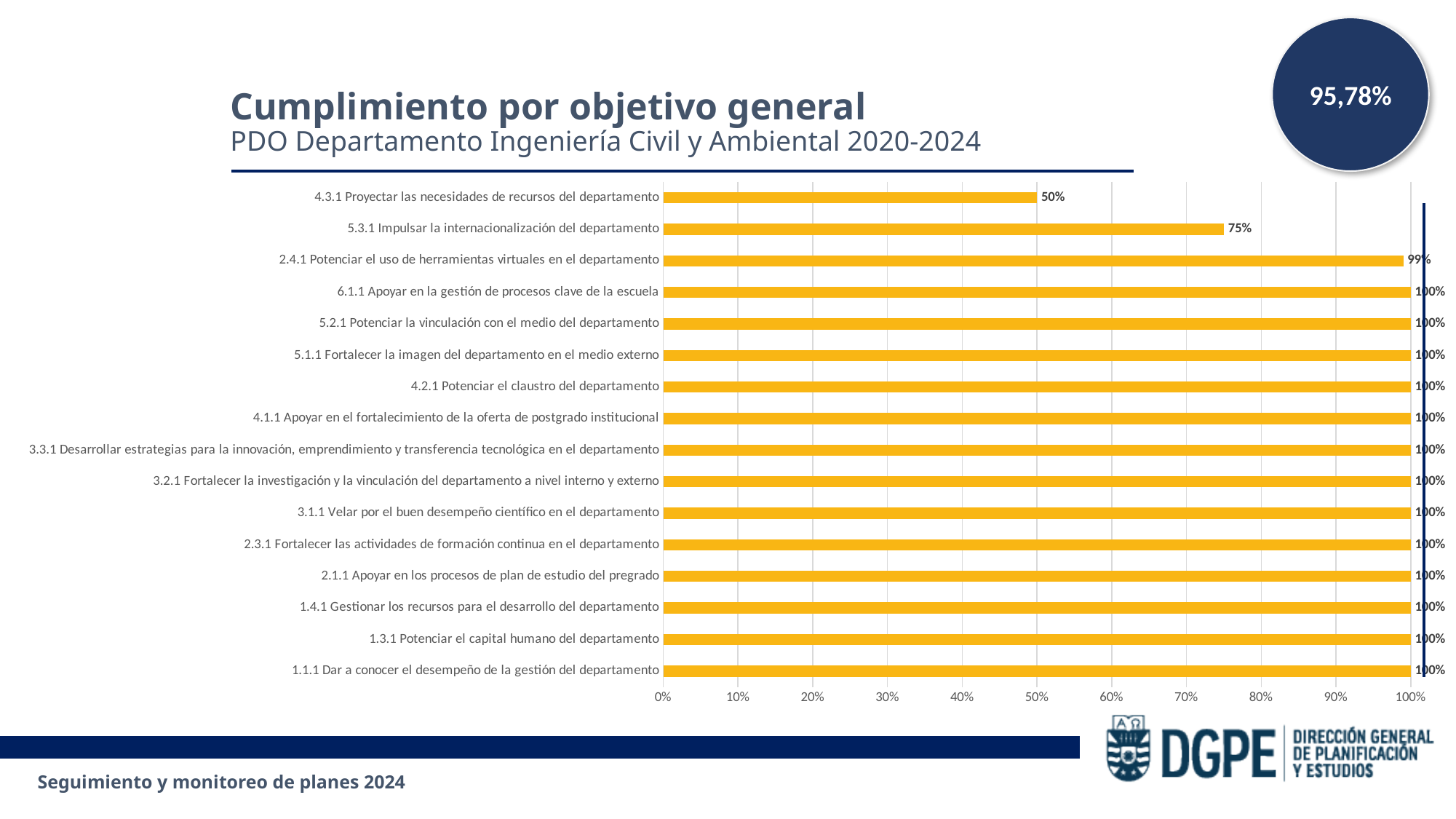
Which objective has the lowest value in the chart? 4.3.1 Proyectar las necesidades de recursos del departamento What is the value for '1.1.1 Dar a conocer el desempeño de la gestión del departamento'? 100% What is the value for '5.3.1 Impulsar la internacionalización del departamento'? 75% What is the difference between the values for '6.1.1 Apoyar en la gestión de procesos clave de la escuela' and '2.4.1 Potenciar el uso de herramientas virtuales en el departamento'? 1% What is the title of the chart on the slide? Cumplimiento por objetivo general How many objectives (categories) are plotted in the chart? 16 Is the value for '5.3.1 Impulsar la internacionalización del departamento' greater or less than 60%? greater What is the value for '2.4.1 Potenciar el uso de herramientas virtuales en el departamento'? 99% Which is larger: the value for '5.3.1 Impulsar la internacionalización del departamento' or the value for '4.3.1 Proyectar las necesidades de recursos del departamento'? 5.3.1 Impulsar la internacionalización del departamento What type of chart is shown on the slide? bar chart What is the value for '4.3.1 Proyectar las necesidades de recursos del departamento'? 50% What is the difference between the values for '5.3.1 Impulsar la internacionalización del departamento' and '4.3.1 Proyectar las necesidades de recursos del departamento'? 25%